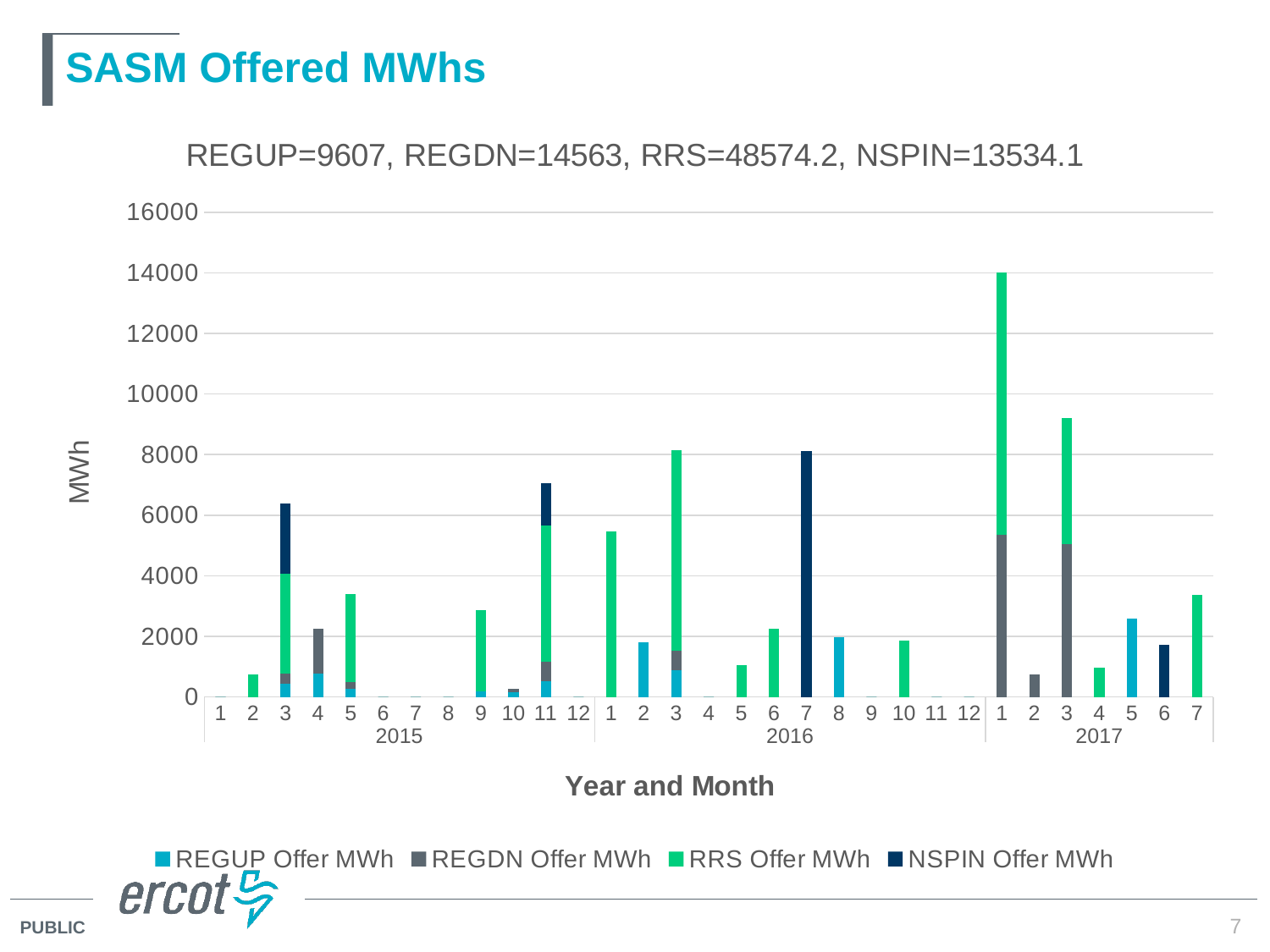
What is the title of the x axis? Year and Month Which is larger, the stacked bar for 2017 month 1 or the stacked bar for 2017 month 3? 2017 month 1 What type of chart is shown on the slide? Stacked bar chart Which ancillary service has the largest total offered MWh according to the chart subtitle? RRS How many series does the legend list? 4 Is the value for 2016 month 7 greater or less than 6000? greater What is the difference between the REGDN total and the REGUP total given in the chart subtitle? 4956 According to the chart subtitle, what is the total NSPIN offered MWh? 13534.1 According to the chart subtitle, what is the total RRS offered MWh? 48574.2 Is the total value for 2017 month 1 greater or less than 12000? greater Which year and month has the tallest stacked bar? 2017, month 1 According to the chart subtitle, what is the total REGUP offered MWh? 9607